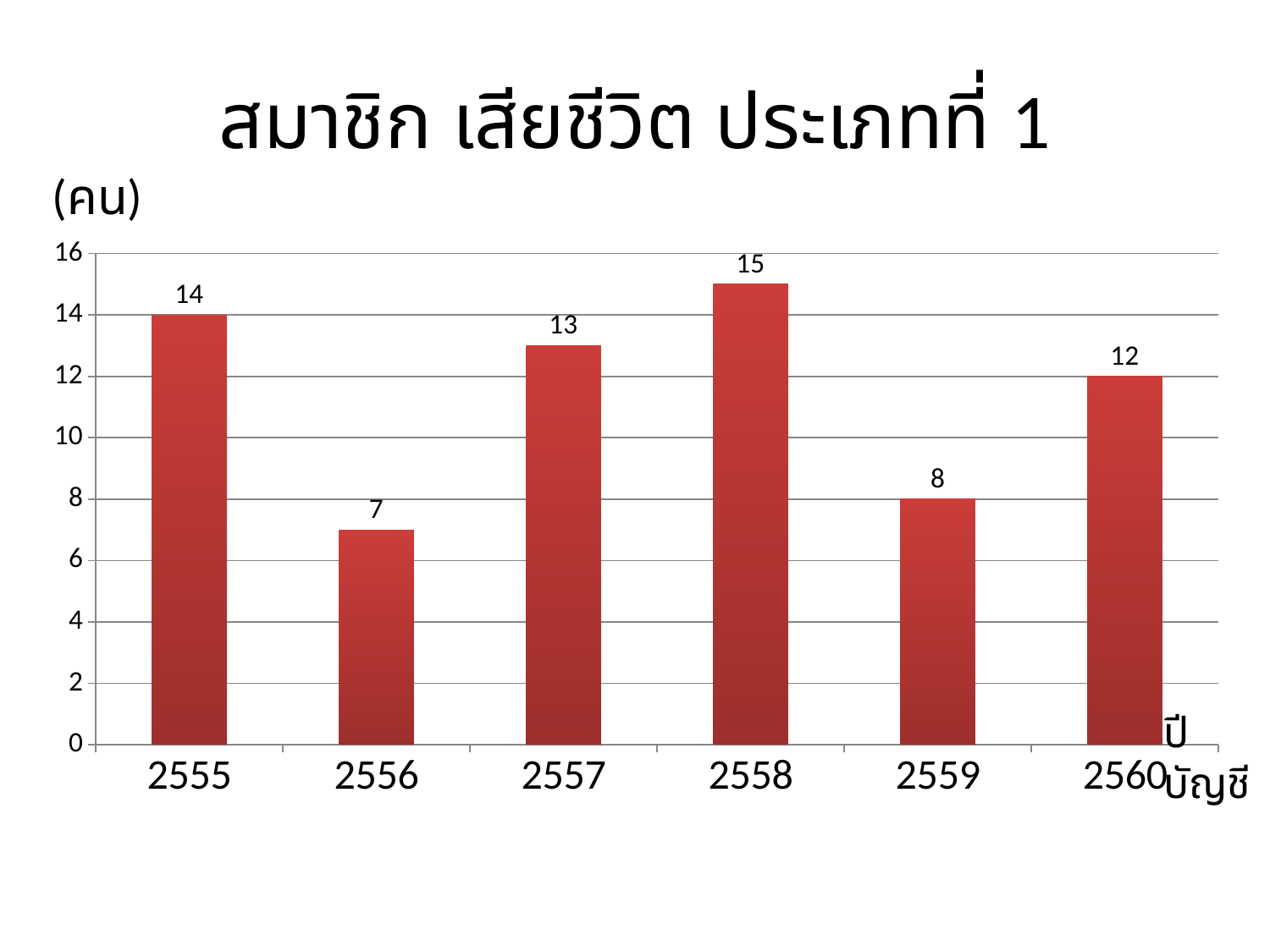
Which is larger, the value for 2557 or the value for 2559? 2557 What is the difference between the values for 2555 and 2560? 2 How many years are shown on the x axis? 6 What is the difference between the values for 2558 and 2556? 8 Which year has the lowest value? 2556 What kind of chart is shown on the slide? bar chart What is the value for 2555? 14 What is the value for 2559? 8 What is the value for 2556? 7 Which year has the highest value? 2558 What is the title of the chart? สมาชิก เสียชีวิต ประเภทที่ 1 Is the value for 2560 greater or less than 10? greater